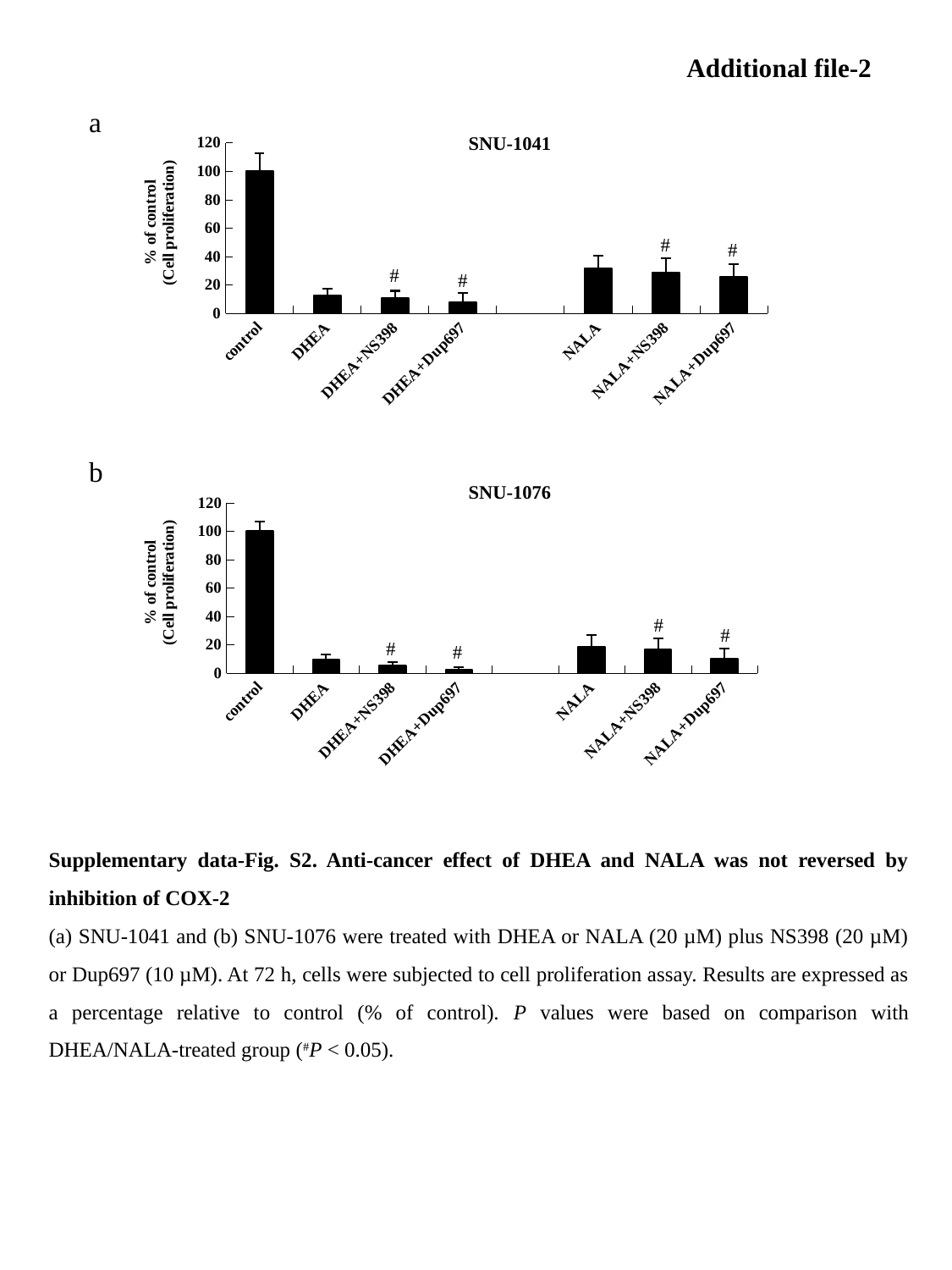
In the SNU-1041 chart, is the value for DHEA greater or less than 20? less How many categories are shown on the x axis of the SNU-1076 chart? 7 What is the title of the top chart? SNU-1041 In the SNU-1041 chart, which is larger, the value for NALA or the value for DHEA? NALA What kind of chart is the SNU-1041 chart? bar chart In the SNU-1076 chart, which category has the lowest value? DHEA+Dup697 In the SNU-1041 chart, is the value for NALA greater or less than 20? greater In the SNU-1076 chart, is the value for DHEA+NS398 greater or less than 20? less In the SNU-1041 chart, which category has the highest value? control In the SNU-1041 chart, what is the value for control? 100 What is the y-axis label of the SNU-1076 chart? % of control (Cell proliferation)